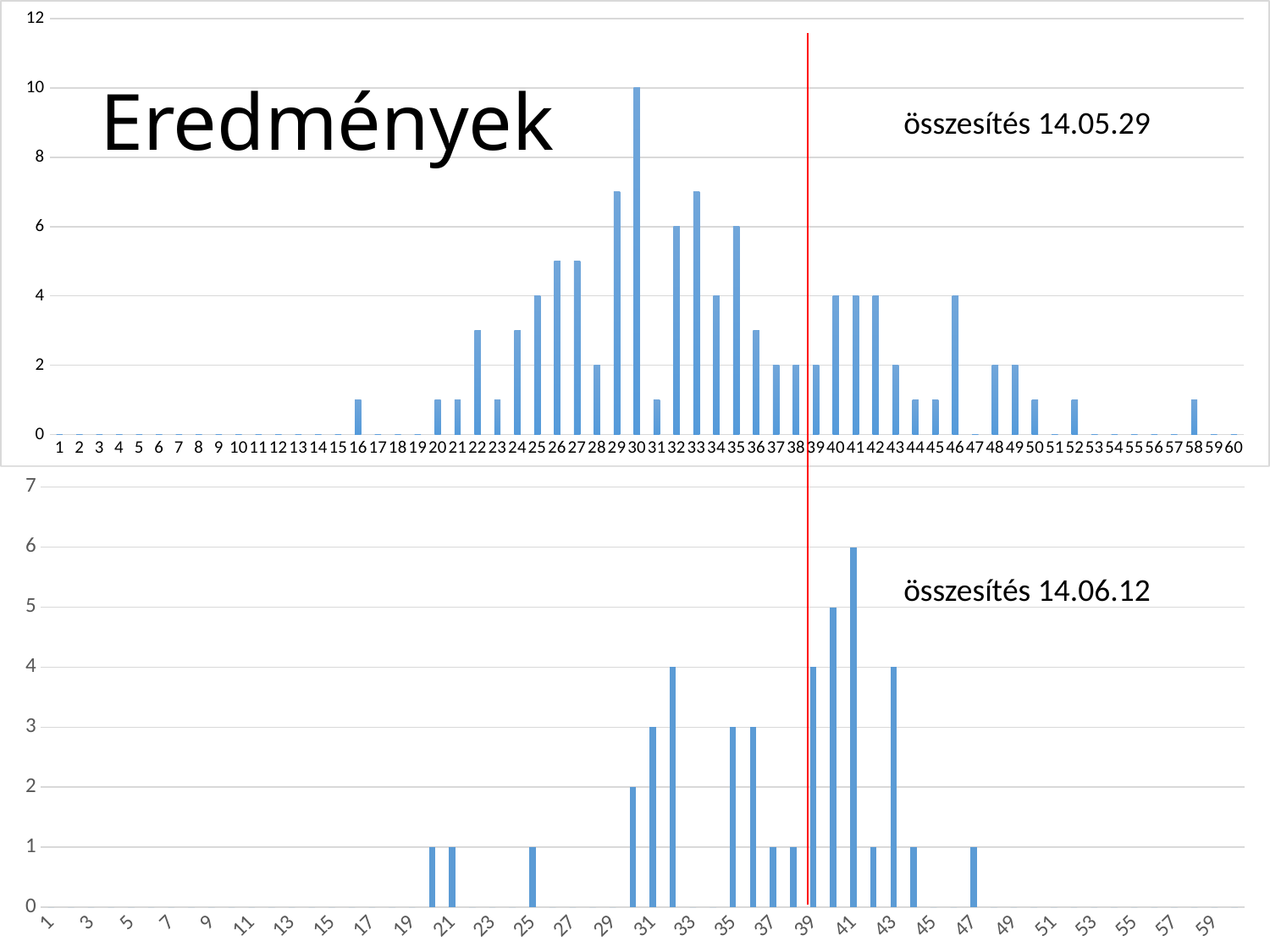
In the bottom chart 'összesítés 14.06.12', which is larger, the value for category 43 or for category 35? 43 In the top chart 'összesítés 14.05.29', which category has the highest value? 30 In the top chart 'összesítés 14.05.29', what is the value for category 46? 4 What is the title shown on the top chart? összesítés 14.05.29 What kind of chart is the top chart titled 'összesítés 14.05.29'? bar chart In the bottom chart 'összesítés 14.06.12', what is the value for category 39? 4 In the bottom chart 'összesítés 14.06.12', what is the value for category 41? 6 In the top chart 'összesítés 14.05.29', which is larger, the value for category 33 or for category 35? 33 In the top chart 'összesítés 14.05.29', what is the value for category 30? 10 In the bottom chart 'összesítés 14.06.12', which category has the highest value? 41